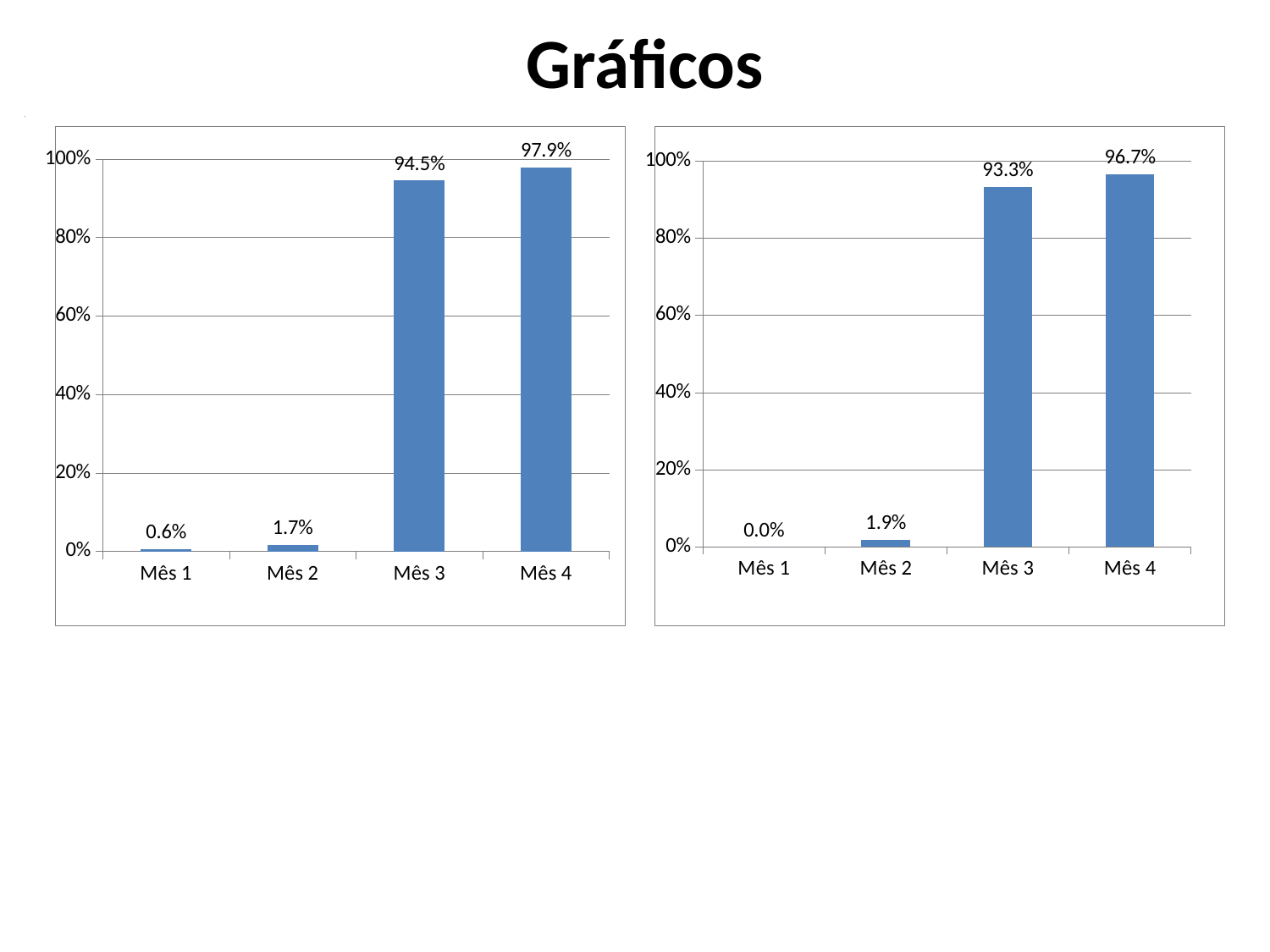
In the left chart, what is the difference between the values for Mês 4 and Mês 3? 3.4% In the left chart, what is the value for Mês 3? 94.5% In the right chart, which category has the lowest value? Mês 1 In the right chart, which is larger, the value for Mês 3 or the value for Mês 4? Mês 4 In the right chart, what is the value for Mês 2? 1.9% In the left chart, do the values rise or fall from Mês 1 to Mês 4? rise What kind of chart is the right chart? bar chart In the right chart, what is the difference between the values for Mês 3 and Mês 2? 91.4% How many categories does the left chart show? 4 In the right chart, what is the value for Mês 4? 96.7% In the left chart, what is the value for Mês 1? 0.6% In the left chart, which category has the highest value? Mês 4